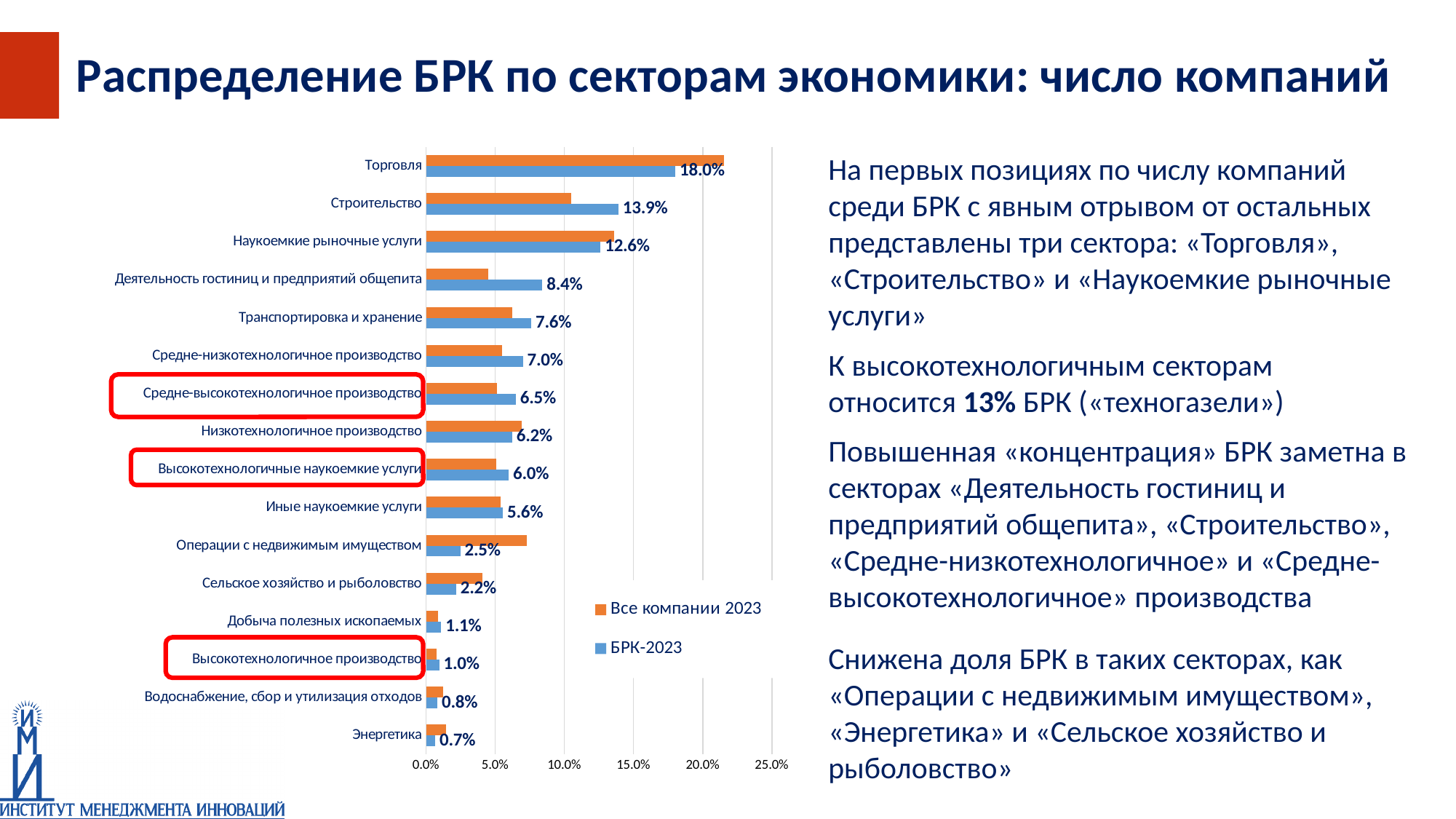
How many sectors are shown in the chart? 16 What is the БРК-2023 value for Торговля? 18.0% Which colour represents the БРК-2023 series in the chart? Blue What is the БРК-2023 value for Высокотехнологичное производство? 1.0% What is the difference between the БРК-2023 values for Торговля and Строительство? 4.1% For Операции с недвижимым имуществом, which series has the larger value: Все компании 2023 or БРК-2023? Все компании 2023 How many series does the legend list? 2 Is the Все компании 2023 value for Торговля greater or less than 20.0%? greater Which sector has the highest БРК-2023 value? Торговля What kind of chart is shown on the slide? Bar chart Which sector has the lowest БРК-2023 value? Энергетика What is the БРК-2023 value for Деятельность гостиниц и предприятий общепита? 8.4%